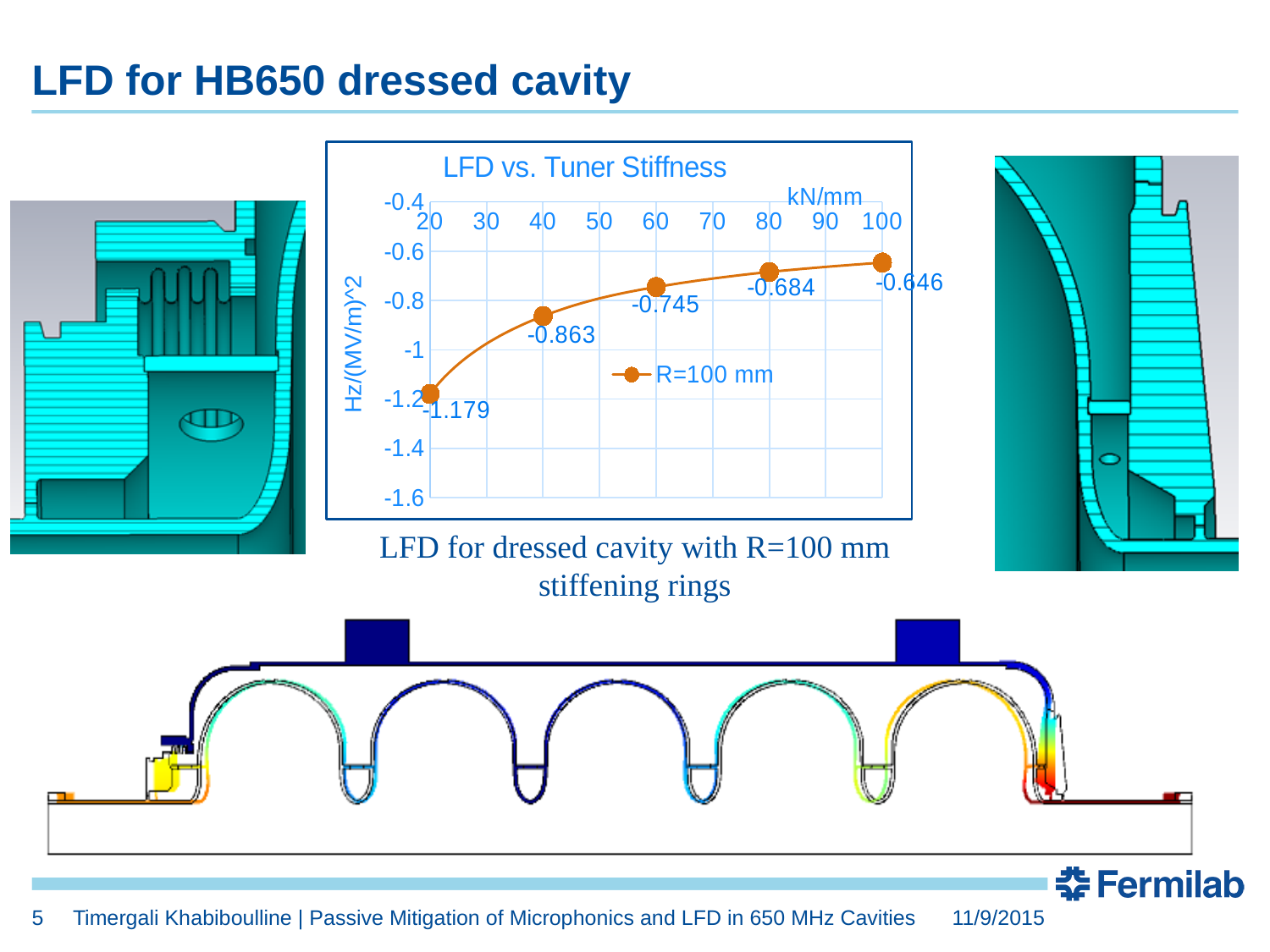
At which tuner stiffness is the LFD value lowest (most negative)? 20 kN/mm What type of chart is shown on the slide? line chart Do the LFD values rise or fall as tuner stiffness increases along the x axis? rise How many series does the legend list? 1 What is the difference between the LFD values at 80 kN/mm and 100 kN/mm? 0.038 What is the title of the chart? LFD vs. Tuner Stiffness At which tuner stiffness is the LFD value highest (least negative)? 100 kN/mm How many data points are plotted on the chart? 5 What is the LFD value at a tuner stiffness of 60 kN/mm? -0.745 What is the LFD value at a tuner stiffness of 40 kN/mm? -0.863 What is the LFD value at a tuner stiffness of 100 kN/mm? -0.646 What is the LFD value at a tuner stiffness of 20 kN/mm? -1.179